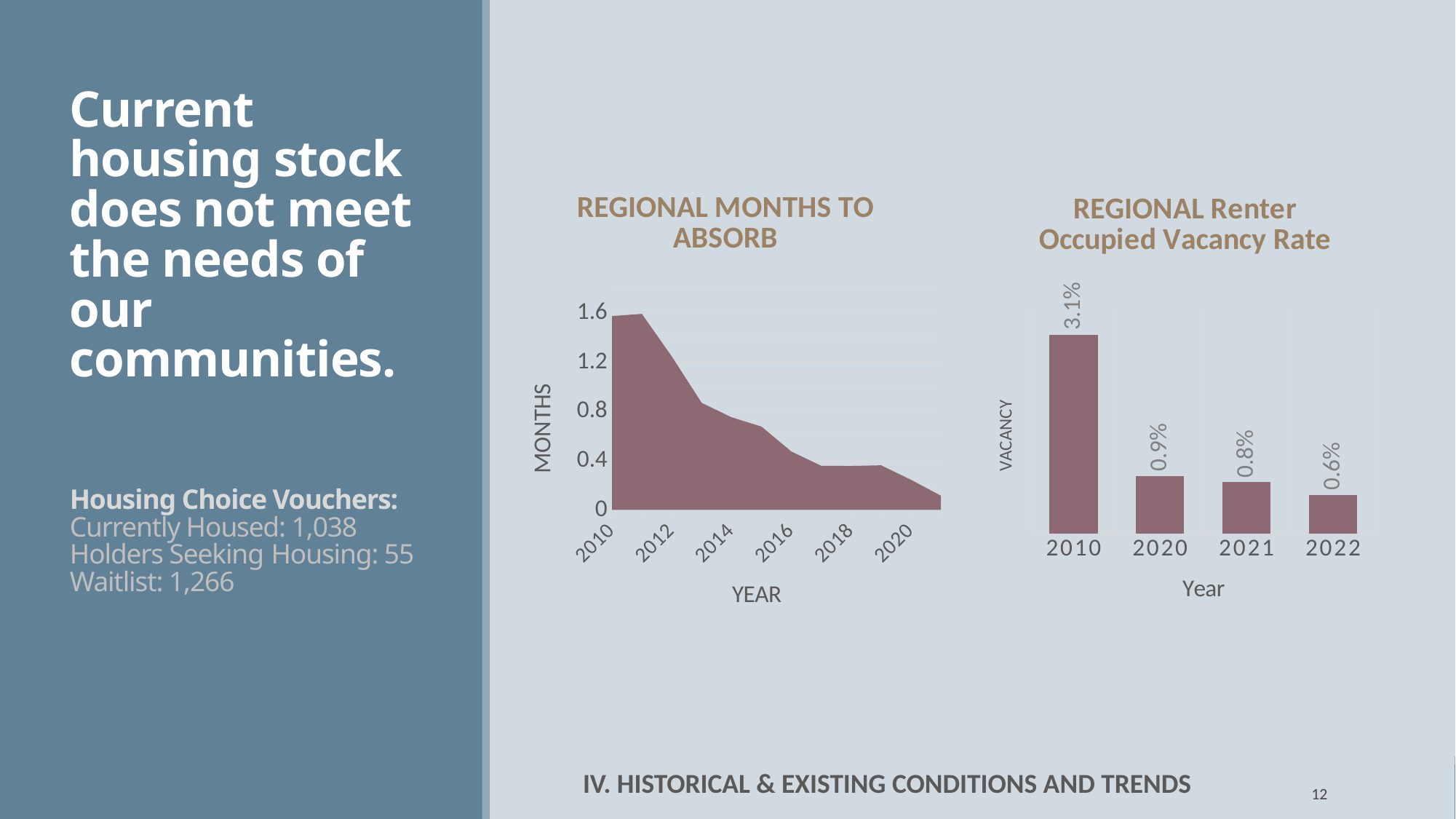
In the REGIONAL Renter Occupied Vacancy Rate chart, which year has the lowest vacancy rate? 2022 In the REGIONAL Renter Occupied Vacancy Rate chart, which is larger, the vacancy rate for 2020 or for 2021? 2020 In the REGIONAL Renter Occupied Vacancy Rate chart, what is the vacancy rate for 2022? 0.6% What kind of chart is the REGIONAL Renter Occupied Vacancy Rate chart? Bar chart In the REGIONAL Renter Occupied Vacancy Rate chart, what is the vacancy rate for 2021? 0.8% In the REGIONAL Renter Occupied Vacancy Rate chart, what is the vacancy rate for 2010? 3.1% In the REGIONAL Renter Occupied Vacancy Rate chart, what is the difference between the 2010 and 2020 vacancy rates? 2.2% In the REGIONAL MONTHS TO ABSORB chart, is the value for 2010 greater or less than 1.2? greater How many years are shown in the REGIONAL Renter Occupied Vacancy Rate chart? 4 In the REGIONAL MONTHS TO ABSORB chart, is the value for 2020 greater or less than 0.8? less In the REGIONAL Renter Occupied Vacancy Rate chart, which year has the highest vacancy rate? 2010 In the REGIONAL MONTHS TO ABSORB chart, do the values rise or fall from 2010 to 2020? Fall